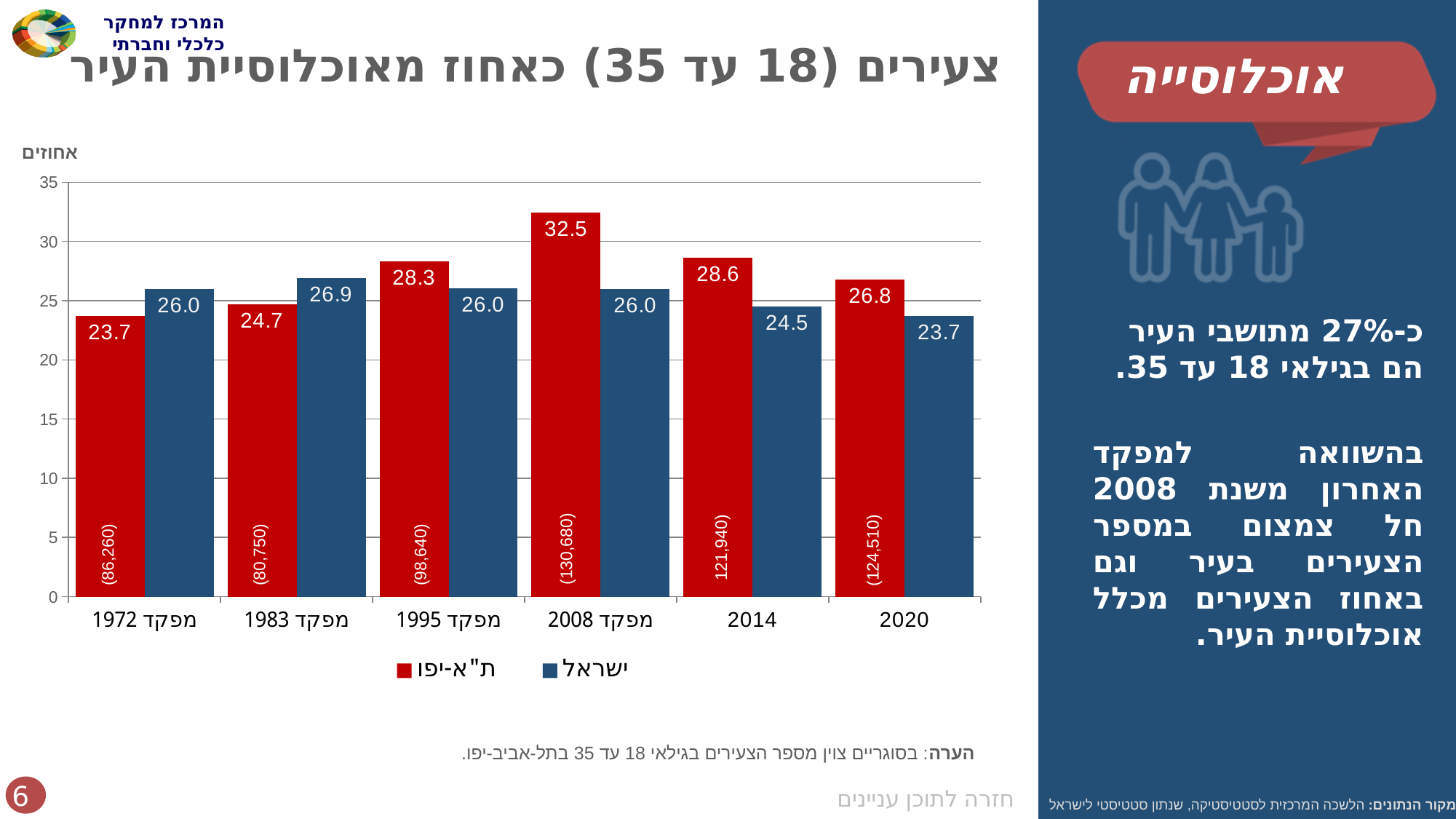
What is the difference between the ת"א-יפו and ישראל values in מפקד 2008? 6.5 Which colour represents ישראל in the chart? blue What number is printed inside the ת"א-יפו bar for מפקד 2008? (130,680) How many series does the legend list? 2 What is the value for ישראל in מפקד 1983? 26.9 In which category is the ישראל value lowest? 2020 What is the value for ת"א-יפו in מפקד 2008? 32.5 Which is larger in מפקד 1972: the ת"א-יפו value or the ישראל value? ישראל What kind of chart is shown on the slide? bar chart What is the value for ת"א-יפו in 2020? 26.8 In which category is the ת"א-יפו value highest? מפקד 2008 How many categories are shown on the x axis? 6